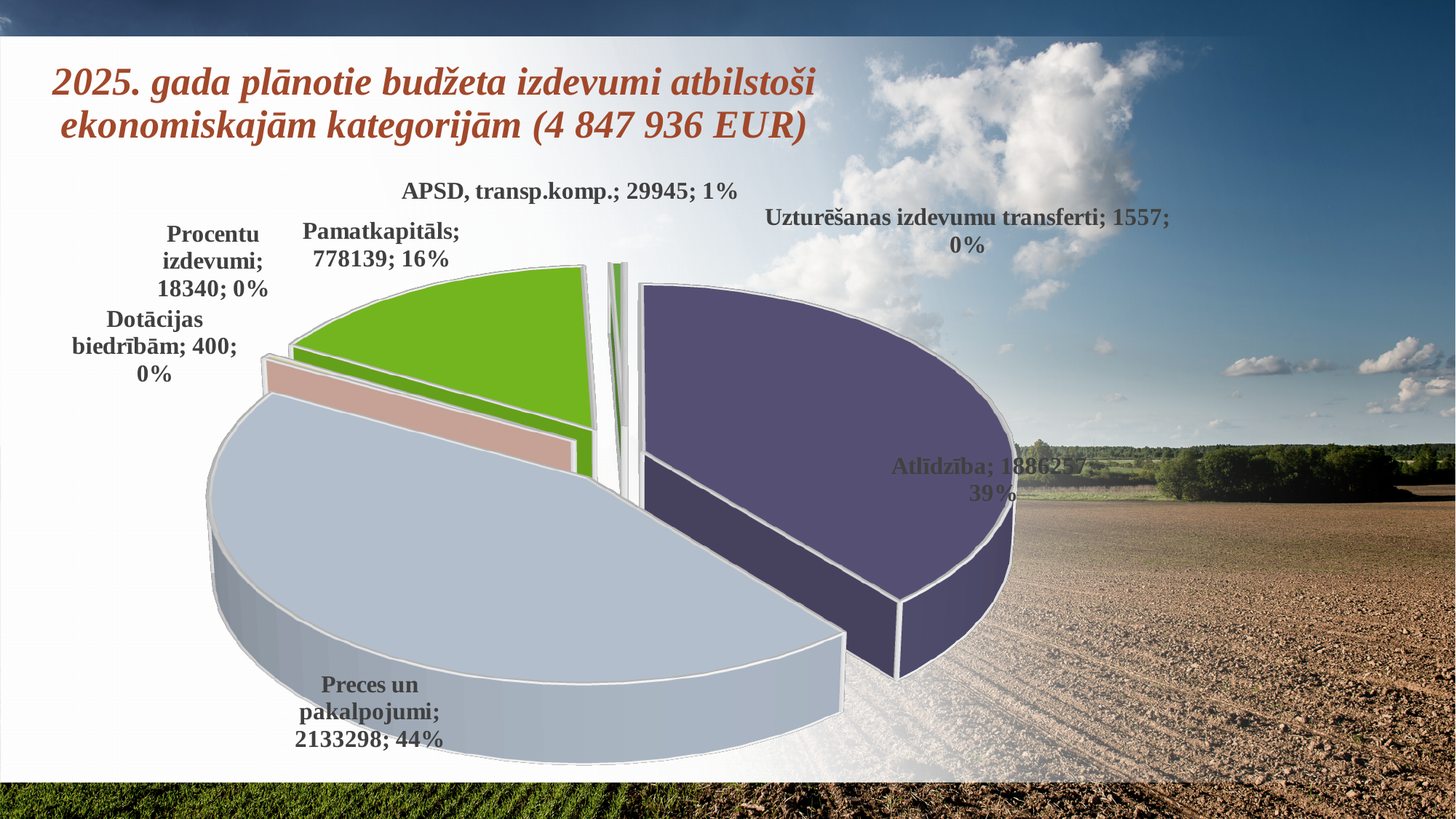
How many categories are shown in the pie chart? 7 What is the value for Atlīdzība? 1886257 Which category has the smallest value? Dotācijas biedrībām What is the value for APSD, transp.komp.? 29945 What share of the pie does Pamatkapitāls represent? 16% Which is larger, the value for Procentu izdevumi or the value for Uzturēšanas izdevumu transferti? Procentu izdevumi What kind of chart is shown on the slide? Pie chart What is the value for Dotācijas biedrībām? 400 What is the difference between the values for Preces un pakalpojumi and Atlīdzība? 247041 What is the value for Pamatkapitāls? 778139 Which category has the largest share of the pie? Preces un pakalpojumi What is the value for Preces un pakalpojumi? 2133298